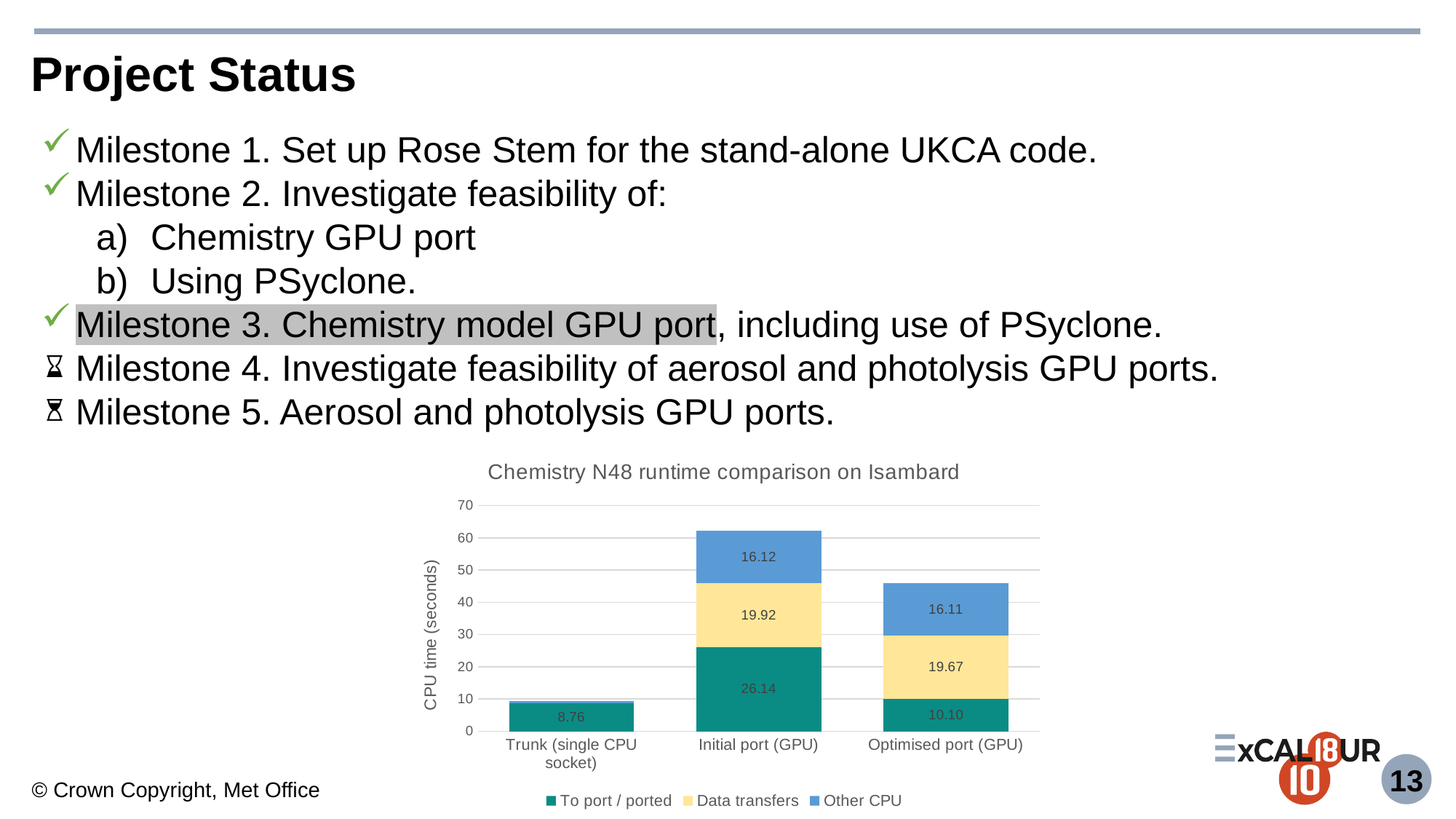
What is the total CPU time for the Initial port (GPU) stacked bar? 62.18 What is the title of the chart? Chemistry N48 runtime comparison on Isambard Is the 'To port / ported' value for Initial port (GPU) greater or less than the 'To port / ported' value for Optimised port (GPU)? greater What type of chart is shown on the slide? Stacked bar chart What is the difference between the 'To port / ported' values for Initial port (GPU) and Optimised port (GPU)? 16.04 What is the 'Other CPU' value for Optimised port (GPU)? 16.11 What is the 'To port / ported' value for Trunk (single CPU socket)? 8.76 What is the total CPU time for the Optimised port (GPU) stacked bar? 45.88 How many categories are shown on the x axis of the chart? 3 What is the 'Data transfers' value for Initial port (GPU)? 19.92 How many series does the chart legend list? 3 Which category has the highest 'To port / ported' value? Initial port (GPU)